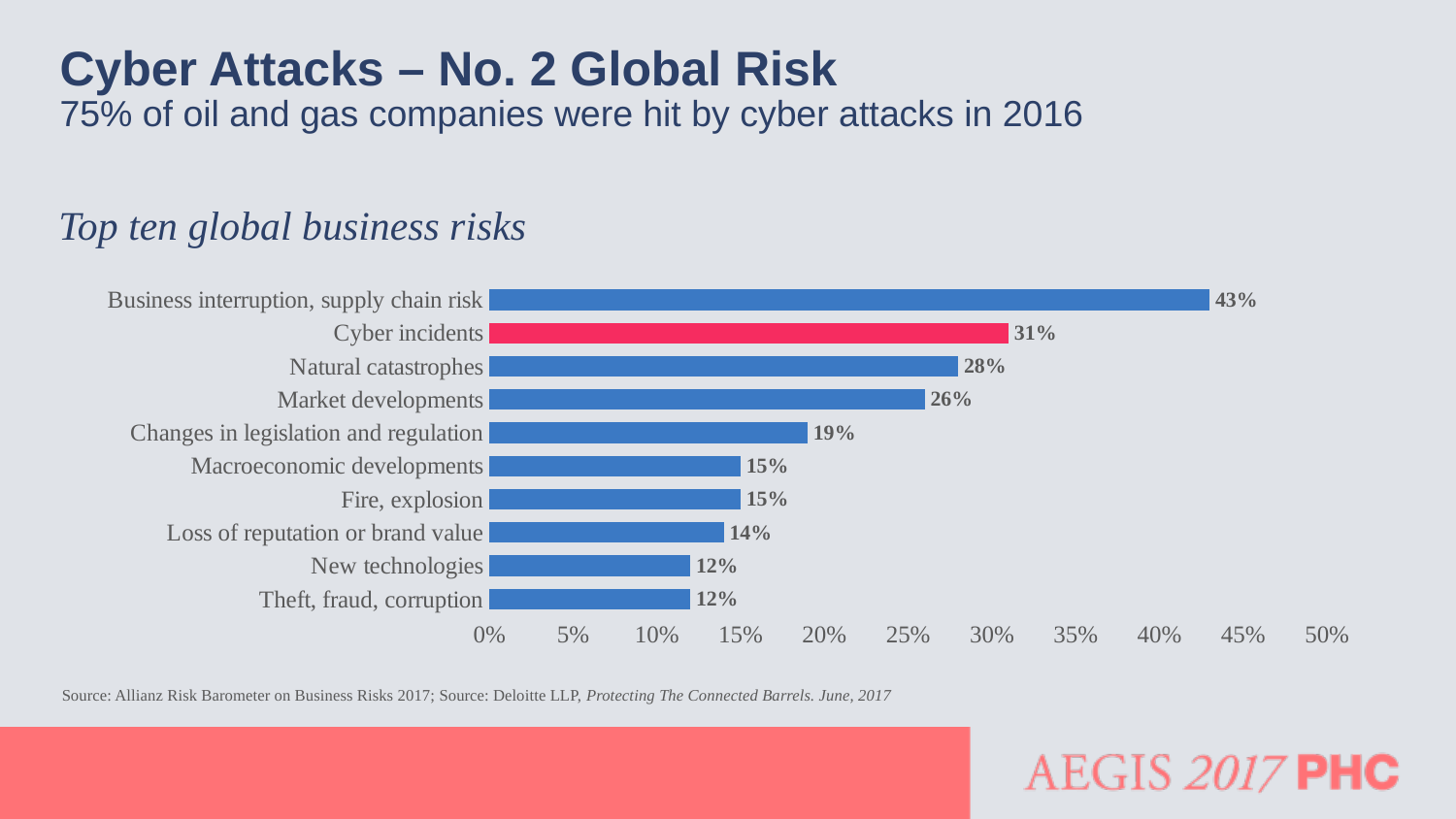
What kind of chart is shown on the slide? Bar chart What is the title of the chart? Top ten global business risks Which is larger, Market developments or Changes in legislation and regulation? Market developments What is the value for Changes in legislation and regulation? 19% What is the difference between Business interruption, supply chain risk and Cyber incidents? 12% What is the value for Cyber incidents? 31% How many categories are shown in the chart? 10 What is the difference between Natural catastrophes and Market developments? 2% Which category has the highest value? Business interruption, supply chain risk What is the value for Loss of reputation or brand value? 14% Is the value for Natural catastrophes greater or less than 25%? greater Which bar is highlighted in a different colour (red) from the others? Cyber incidents